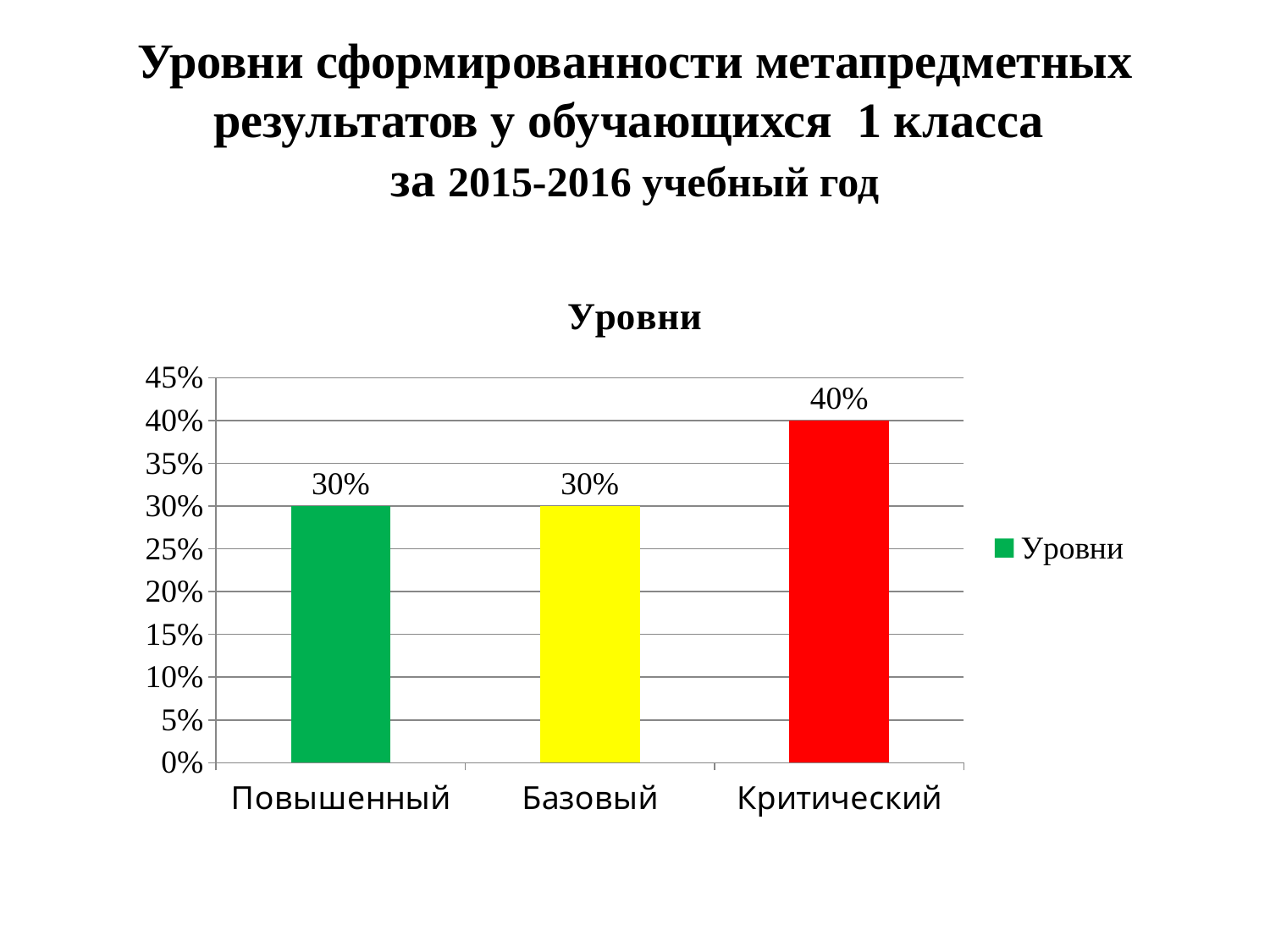
What colour is the bar for Критический? red Which category has the highest value? Критический What is the value for Повышенный? 30% Which is larger, the value for Критический or the value for Повышенный? Критический What is the value for Базовый? 30% How many series does the legend list? 1 What is the title of the chart? Уровни Is the value for Критический greater or less than 35%? greater What is the value for Критический? 40% What kind of chart is shown? bar chart How many categories are shown on the x axis? 3 What is the difference between the values for Критический and Базовый? 10%